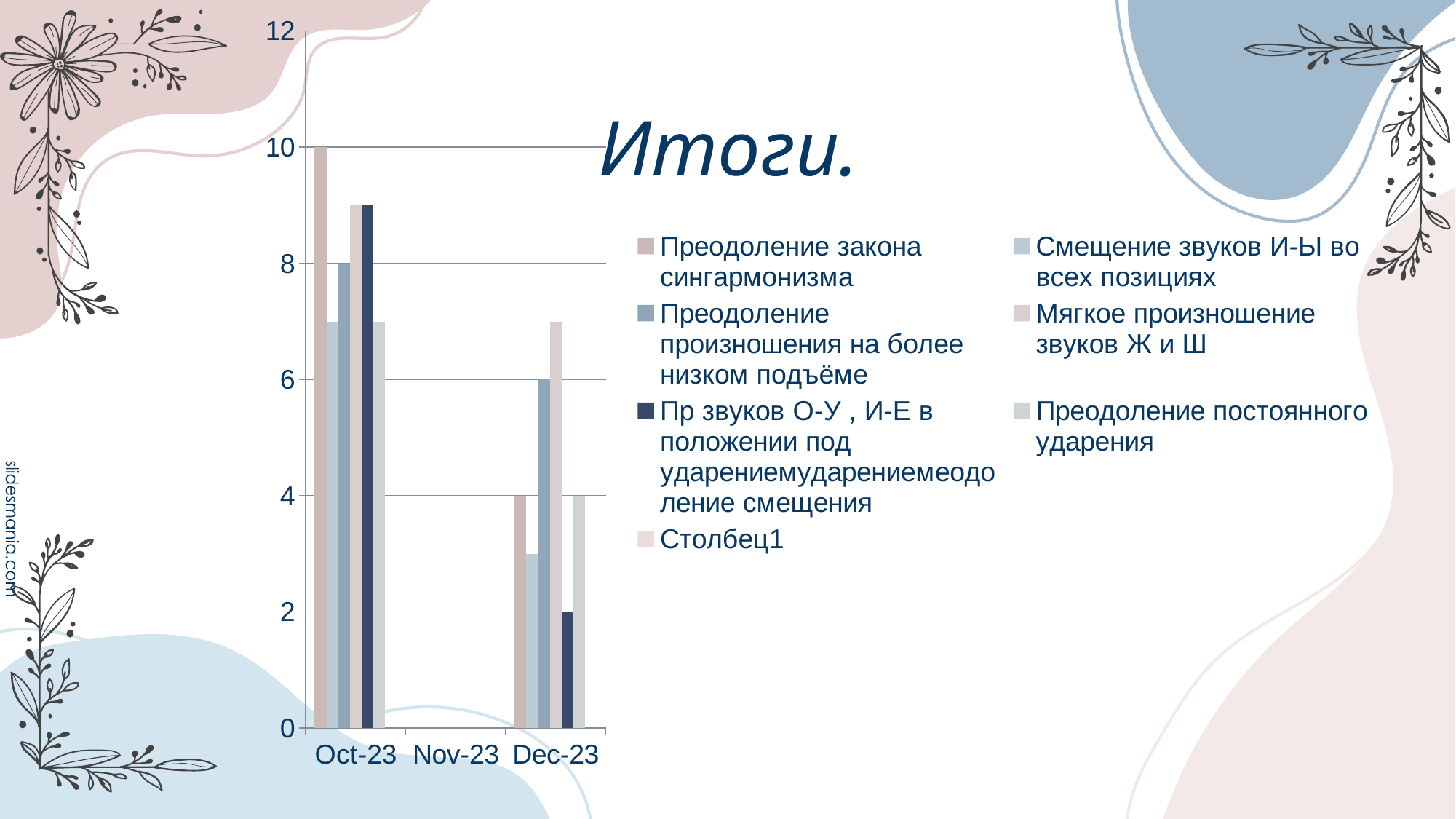
What is the title of the slide containing the chart? Итоги. Which series has the lowest value in Dec-23? Пр звуков О-У, И-Е в положении под ударением Which month has no bars plotted in the chart? Nov-23 What kind of chart is shown on the slide? Bar chart How many series does the chart legend list? 7 How many categories are shown on the x axis of the chart? 3 What is the value of 'Преодоление закона сингармонизма' for Oct-23? 10 Which series has the highest value in Oct-23? Преодоление закона сингармонизма What is the value of the dark navy series (Пр звуков О-У, И-Е в положении под ударением...) for Dec-23? 2 What is the value of 'Преодоление закона сингармонизма' for Dec-23? 4